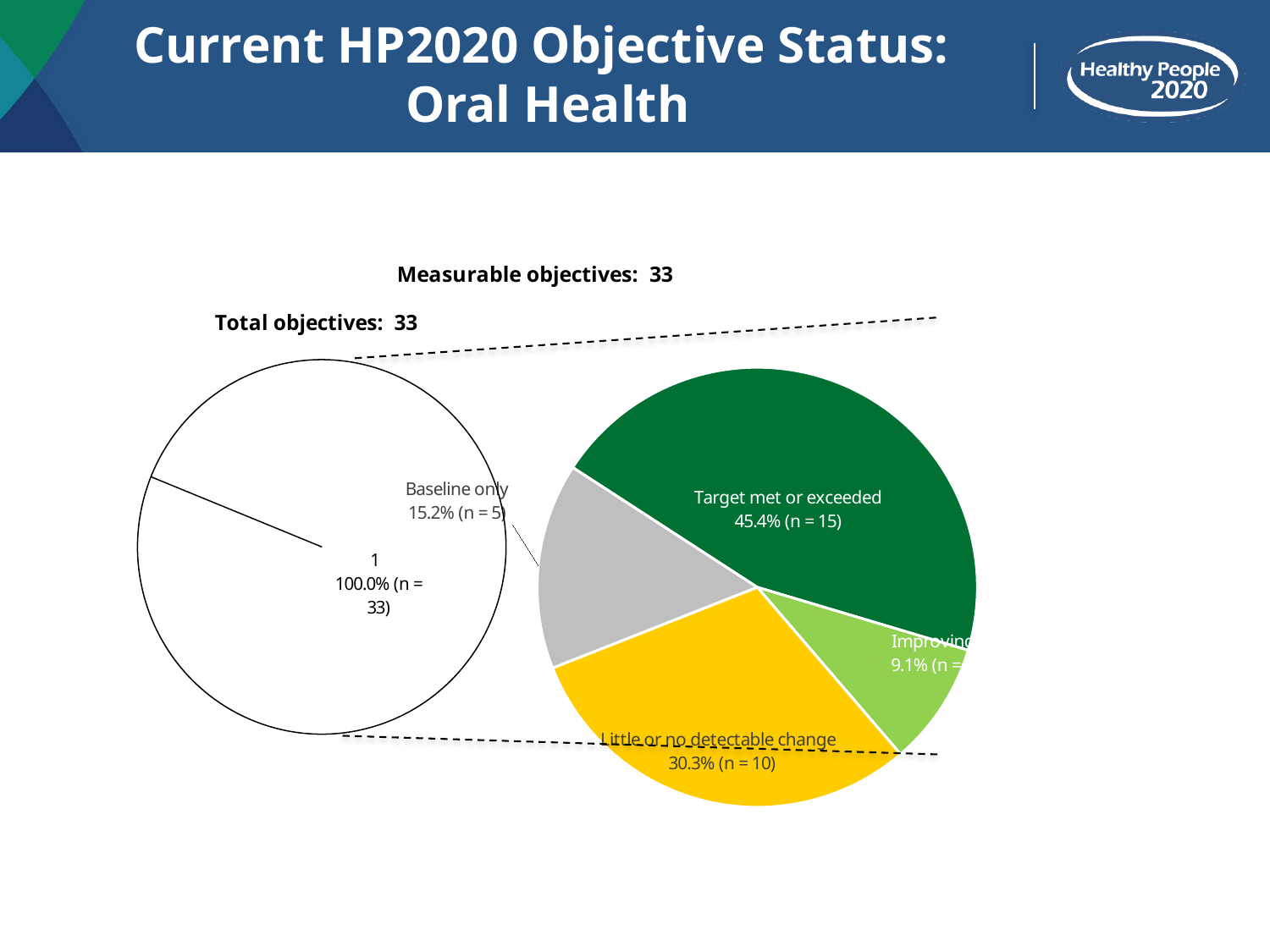
In the measurable objectives pie chart, how many slices are there? 4 What kind of chart is used to show the measurable objectives on the slide? pie chart In the measurable objectives pie chart, how many objectives are 'Baseline only'? 5 In the measurable objectives pie chart, which category has the smallest share? Improving In the measurable objectives pie chart, how many objectives are in the 'Target met or exceeded' category? 15 In the measurable objectives pie chart, what share of objectives is 'Target met or exceeded'? 45.4% In the measurable objectives pie chart, which category has the largest share? Target met or exceeded In the measurable objectives pie chart, which is larger: 'Baseline only' or 'Little or no detectable change'? Little or no detectable change In the measurable objectives pie chart, what share of objectives shows 'Little or no detectable change'? 30.3% How many total objectives are shown in the left pie chart? 33 In the measurable objectives pie chart, what is the difference in percentage points between 'Target met or exceeded' and 'Little or no detectable change'? 15.1 In the measurable objectives pie chart, what percentage of objectives is 'Improving'? 9.1%